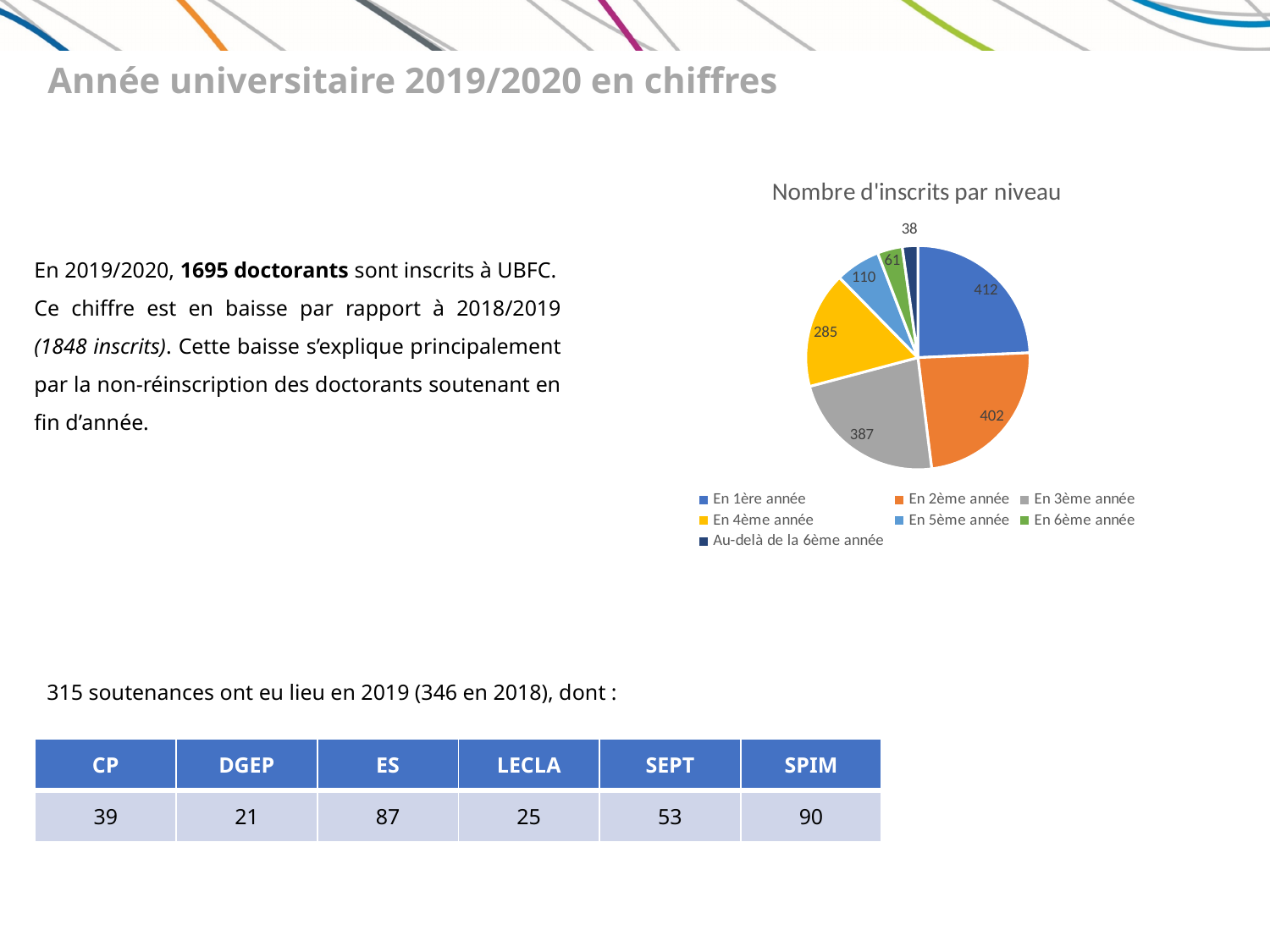
Which category has the smallest slice of the pie? Au-delà de la 6ème année What kind of chart is shown on the slide? pie chart Which category has the largest slice of the pie? En 1ère année How many slices does the pie chart have? 7 How many entries does the chart legend list? 7 What is the value for 'En 5ème année'? 110 What is the difference between the values for 'En 4ème année' and 'En 5ème année'? 175 What is the title of the chart? Nombre d'inscrits par niveau What is the value for 'En 1ère année'? 412 What is the value for 'En 3ème année'? 387 What is the value for 'Au-delà de la 6ème année'? 38 Which is larger, the value for 'En 2ème année' or 'En 3ème année'? En 2ème année